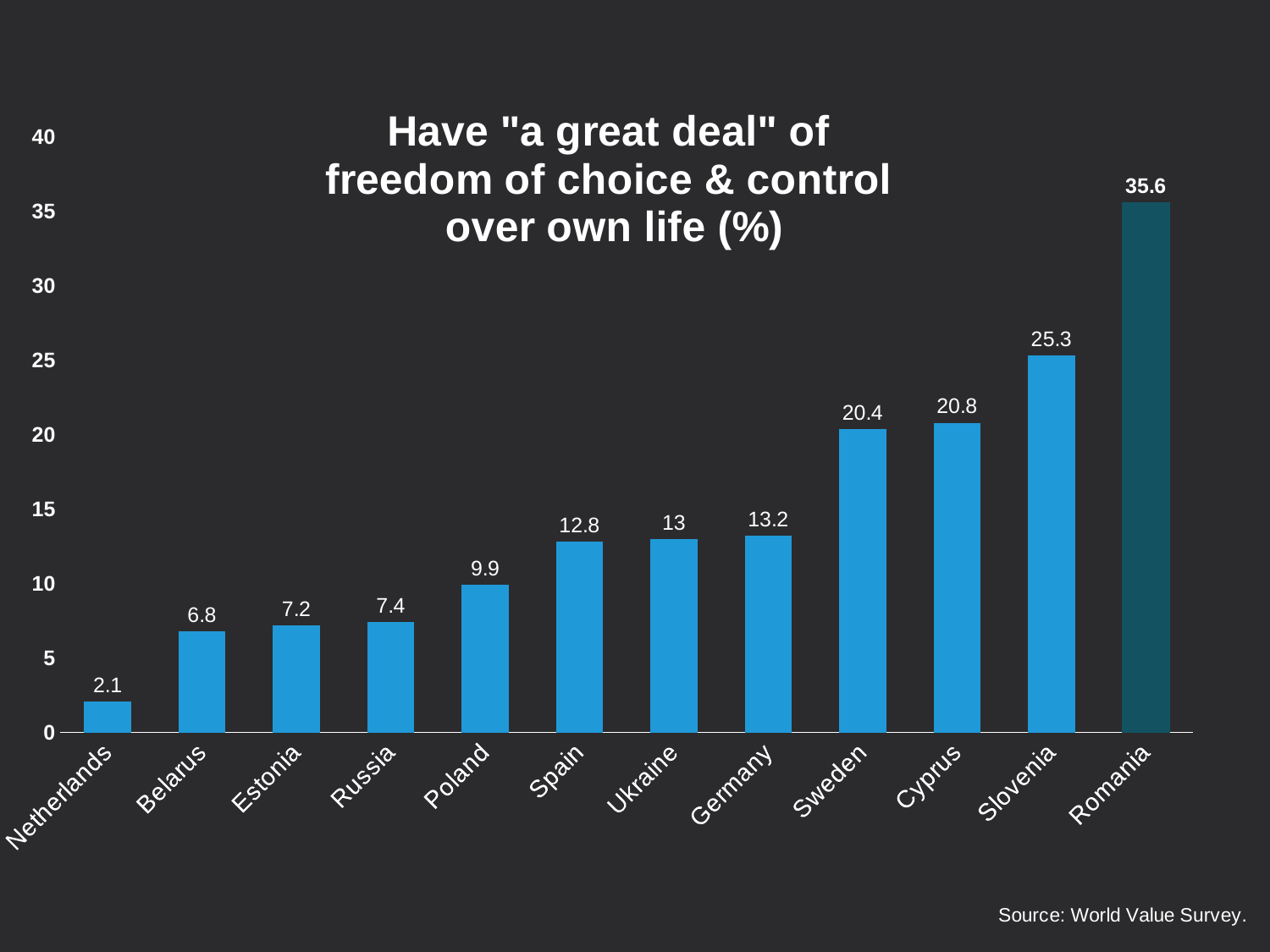
What is the value for Sweden? 20.4 Do the values rise or fall from left to right along the x axis? Rise Is the value for Cyprus greater or less than 20? greater What kind of chart is shown on the slide? Bar chart Which country has the lowest value? Netherlands Which has a larger value, Poland or Spain? Spain Which country has the highest value? Romania What is the difference between the values for Romania and Slovenia? 10.3 What is the value for Romania? 35.6 How many countries are shown in the chart? 12 What is the source cited for the chart? World Value Survey What is the value for Netherlands? 2.1